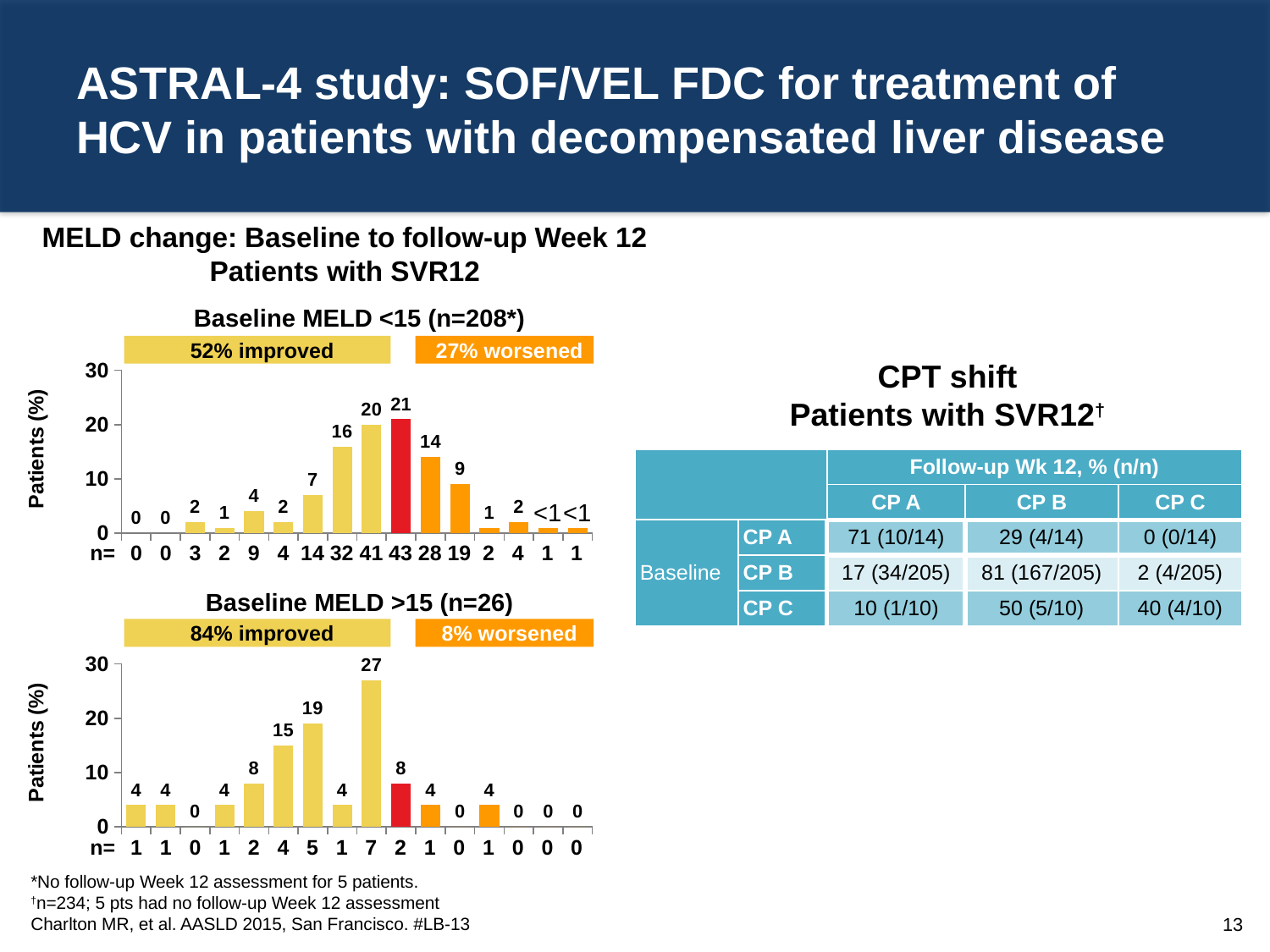
In the 'Baseline MELD <15 (n=208*)' chart, what value is labelled on the red bar? 21 What percentage of patients improved according to the banner on the 'Baseline MELD <15 (n=208*)' chart? 52% improved In the 'Baseline MELD >15 (n=26)' chart, what value is labelled on the red bar? 8 In the 'Baseline MELD <15 (n=208*)' chart, what is the difference between the red bar (21) and the tallest yellow bar (20)? 1 In the 'Baseline MELD >15 (n=26)' chart, what is the highest value shown on any bar? 27 In the 'Baseline MELD >15 (n=26)' chart, what is the difference between the tallest bar and the red bar? 19 In the 'Baseline MELD <15 (n=208*)' chart, what is the highest value shown on any bar? 21 In the 'Baseline MELD <15 (n=208*)' chart, what is the n value shown beneath the red bar? 43 What percentage of patients worsened according to the banner on the 'Baseline MELD >15 (n=26)' chart? 8% worsened What type of chart is used for the 'Baseline MELD <15 (n=208*)' panel? bar chart How many bars are plotted in the 'Baseline MELD >15 (n=26)' chart? 16 In the 'Baseline MELD <15 (n=208*)' chart, which is larger: the red bar or the first orange bar to its right? the red bar